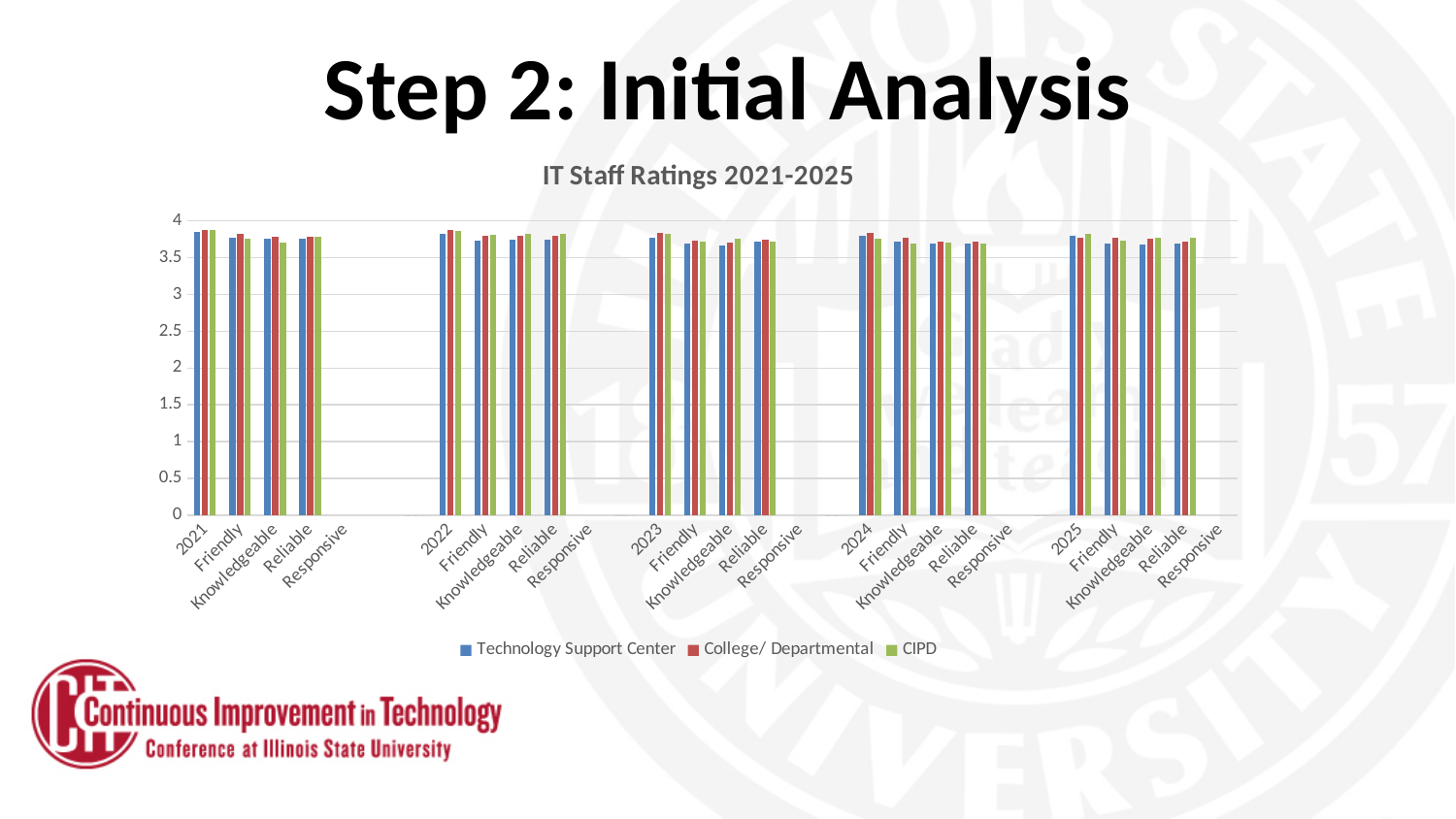
What kind of chart is shown on the slide? bar chart Is the value for Technology Support Center in the first 2021 group greater or less than 3.5? greater What is the title of the chart? IT Staff Ratings 2021-2025 Is the value for College/ Departmental in the first 2023 group greater or less than 3? greater Are any of the plotted bars below 3.5 on the y axis? No How many years are covered by the chart's x axis? 5 How many series does the legend list? 3 Which series are listed in the chart legend? Technology Support Center, College/ Departmental, CIPD What is the highest value shown on the y axis? 4